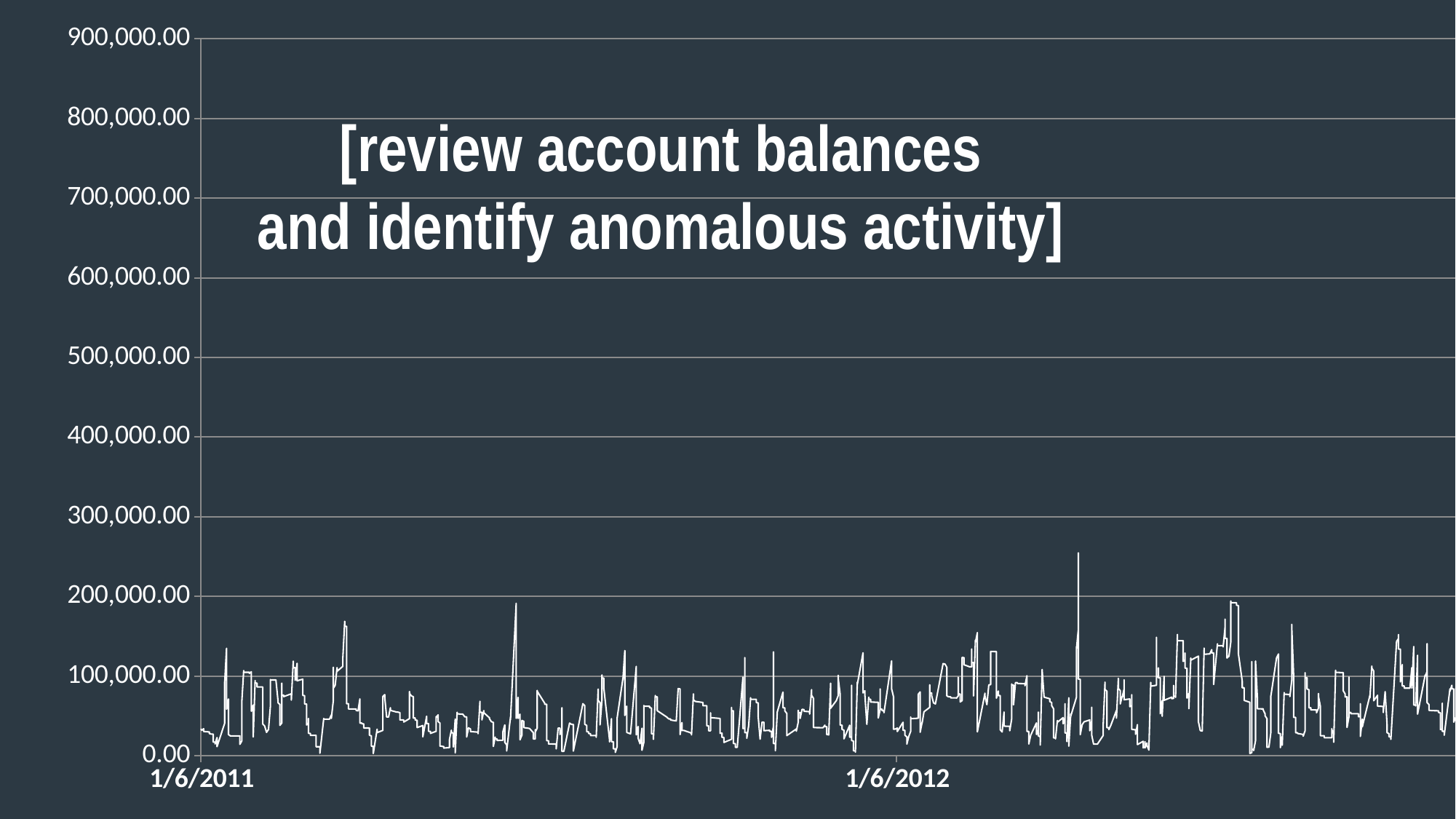
Is the value at the start of the series, at 1/6/2011, greater or less than 100,000.00? less Is the highest peak of the plotted line greater or less than 200,000.00? greater Is the highest peak of the plotted line greater or less than 300,000.00? less What kind of chart is shown on the slide? line chart What are the two date labels shown on the x axis? 1/6/2011 and 1/6/2012 What text is written over the chart? [review account balances and identify anomalous activity] How many date labels are shown on the x axis? 2